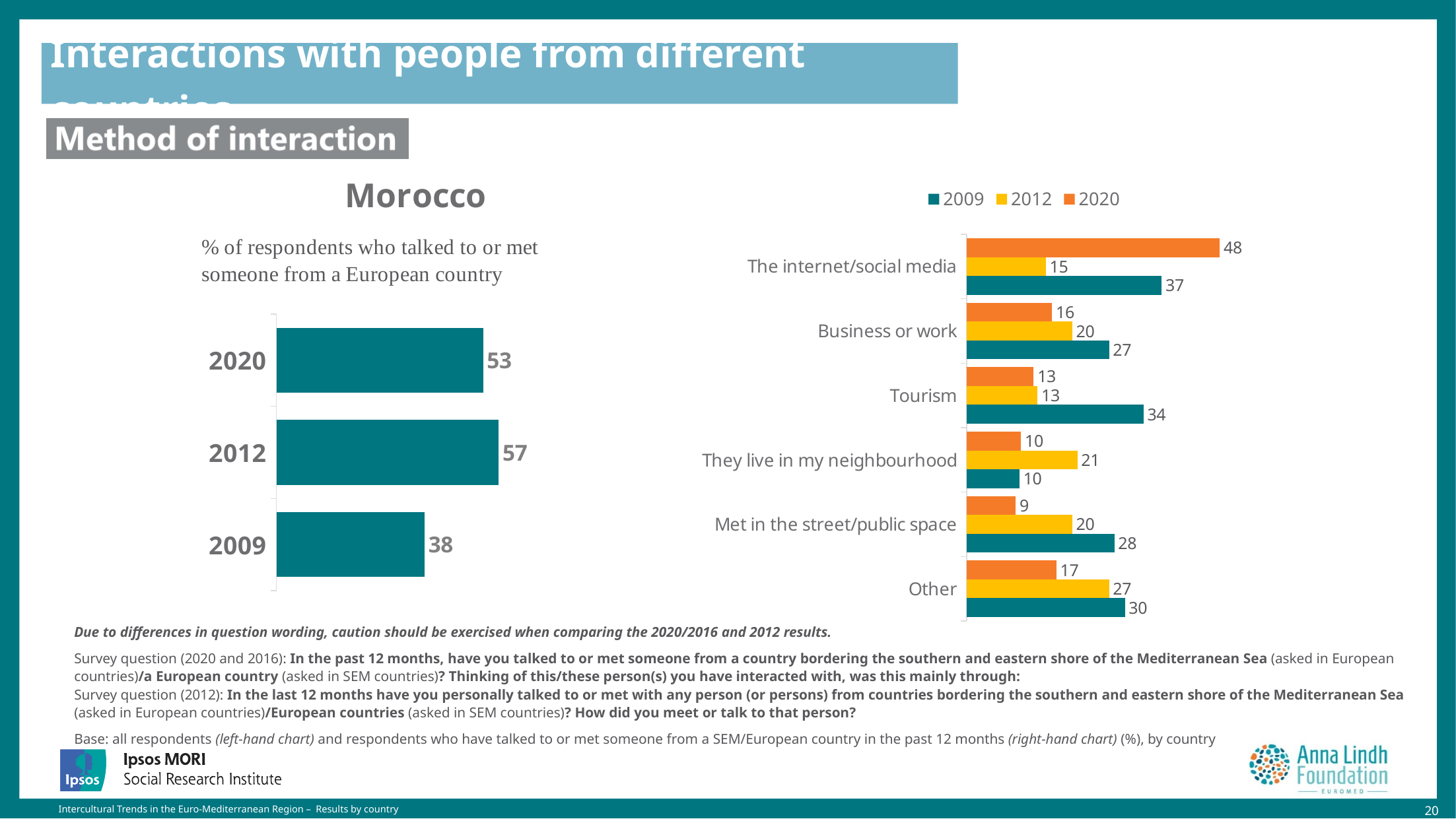
In the left-hand chart, which year has the lowest value? 2009 In the right-hand chart, which method has the lowest 2020 value? Met in the street/public space In the right-hand chart, what is the 2012 value for They live in my neighbourhood? 21 In the right-hand chart, what is the difference between the 2009 and 2012 values for Tourism? 21 In the right-hand chart, how many series does the legend list? 3 In the left-hand chart, what is the difference between the 2012 and 2020 values? 4 In the right-hand chart, which method has the highest 2009 value? The internet/social media In the left-hand chart (% of respondents who talked to or met someone from a European country), what is the value for 2012? 57 In the left-hand chart, how many bars are plotted? 3 In the right-hand chart, which is larger for Business or work: the 2009 value or the 2020 value? 2009 What kind of chart is the right-hand chart? Bar chart In the right-hand chart (method of interaction), what is the 2020 value for The internet/social media? 48